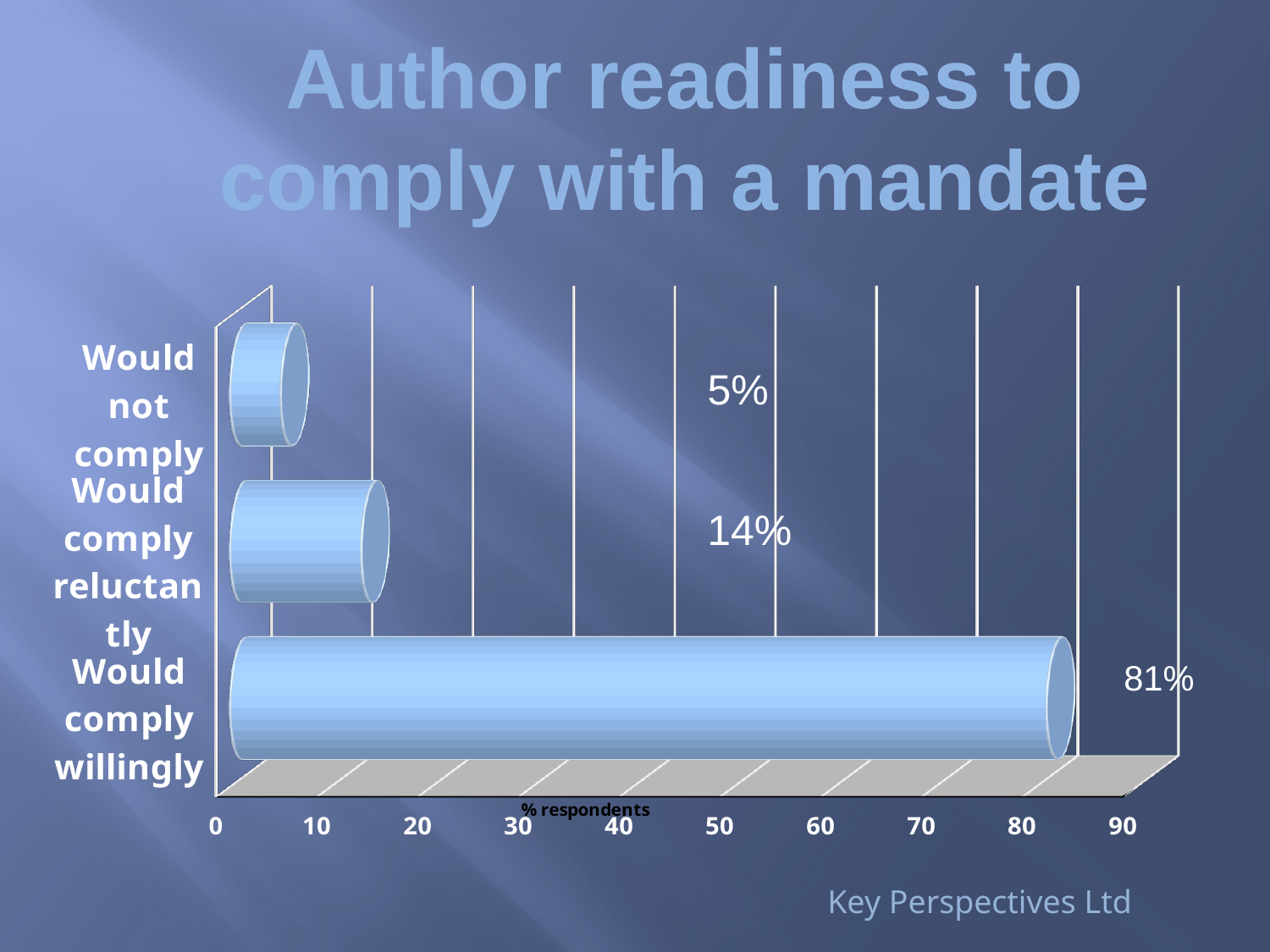
What percentage of respondents would comply willingly with a mandate? 81% Which category has the highest value? Would comply willingly How many categories are shown in the chart? 3 What kind of chart is shown on the slide? Bar chart What is the label of the horizontal axis? % respondents Which category has the lowest value? Would not comply What percentage of respondents would not comply? 5% What is the difference between the share who would comply willingly and the share who would comply reluctantly? 67% Which is larger: the value for 'Would comply reluctantly' or 'Would not comply'? Would comply reluctantly Is the value for 'Would comply willingly' greater or less than 80? greater What is the difference between the share who would comply reluctantly and the share who would not comply? 9% What percentage of respondents would comply reluctantly? 14%